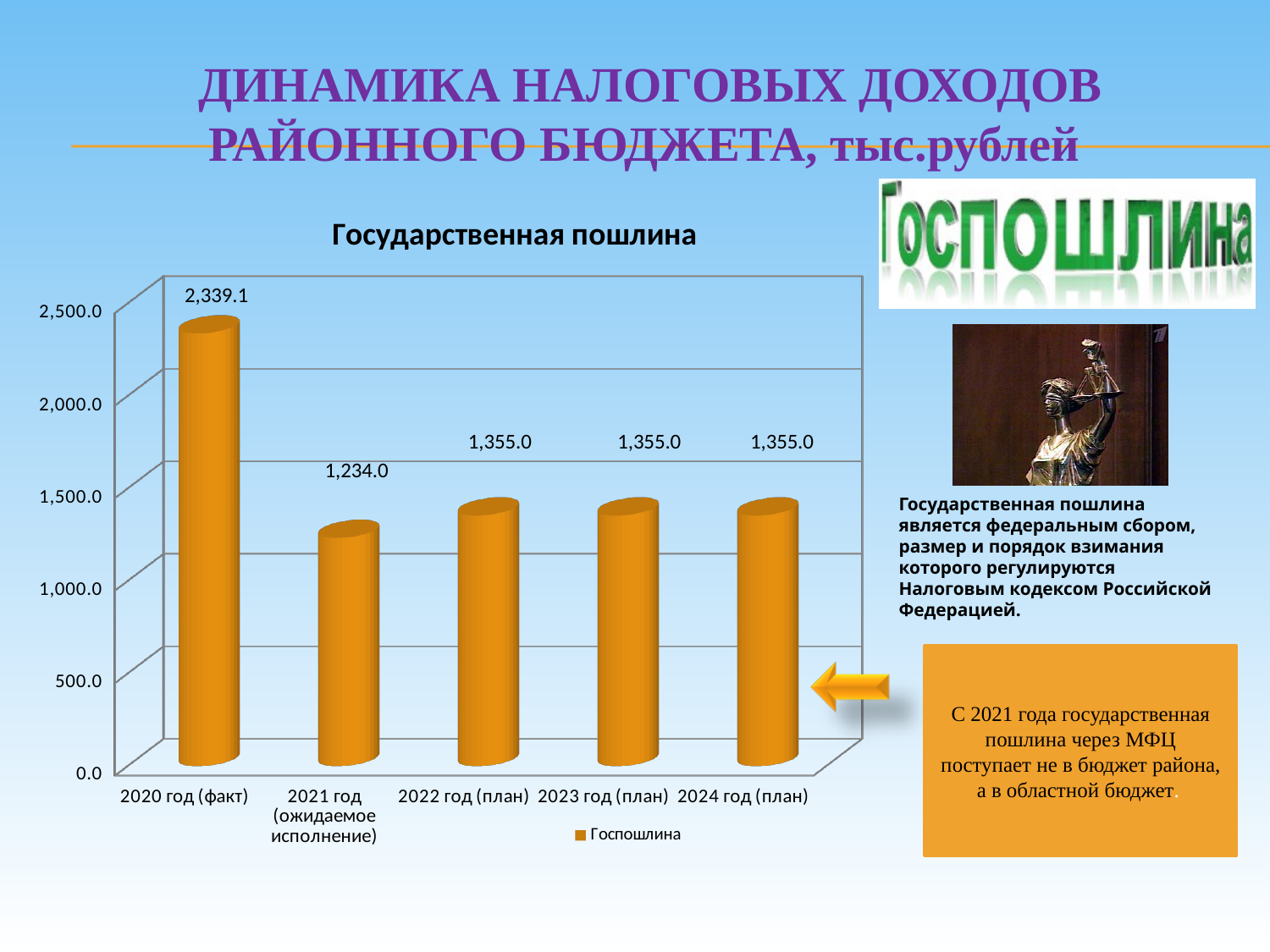
What is the difference between the values for 2022 год (план) and 2021 год (ожидаемое исполнение)? 121.0 Which category has the highest value? 2020 год (факт) Is the value for 2021 год (ожидаемое исполнение) greater or less than 1,500.0? less What kind of chart is shown? bar chart What is the value for 2023 год (план)? 1,355.0 Which category has the lowest value? 2021 год (ожидаемое исполнение) How many categories are shown on the x axis? 5 What is the title of the chart? Государственная пошлина Which is larger, the value for 2020 год (факт) or the value for 2024 год (план)? 2020 год (факт) What is the value for 2020 год (факт)? 2,339.1 What is the value for 2021 год (ожидаемое исполнение)? 1,234.0 What is the difference between the values for 2020 год (факт) and 2021 год (ожидаемое исполнение)? 1,105.1